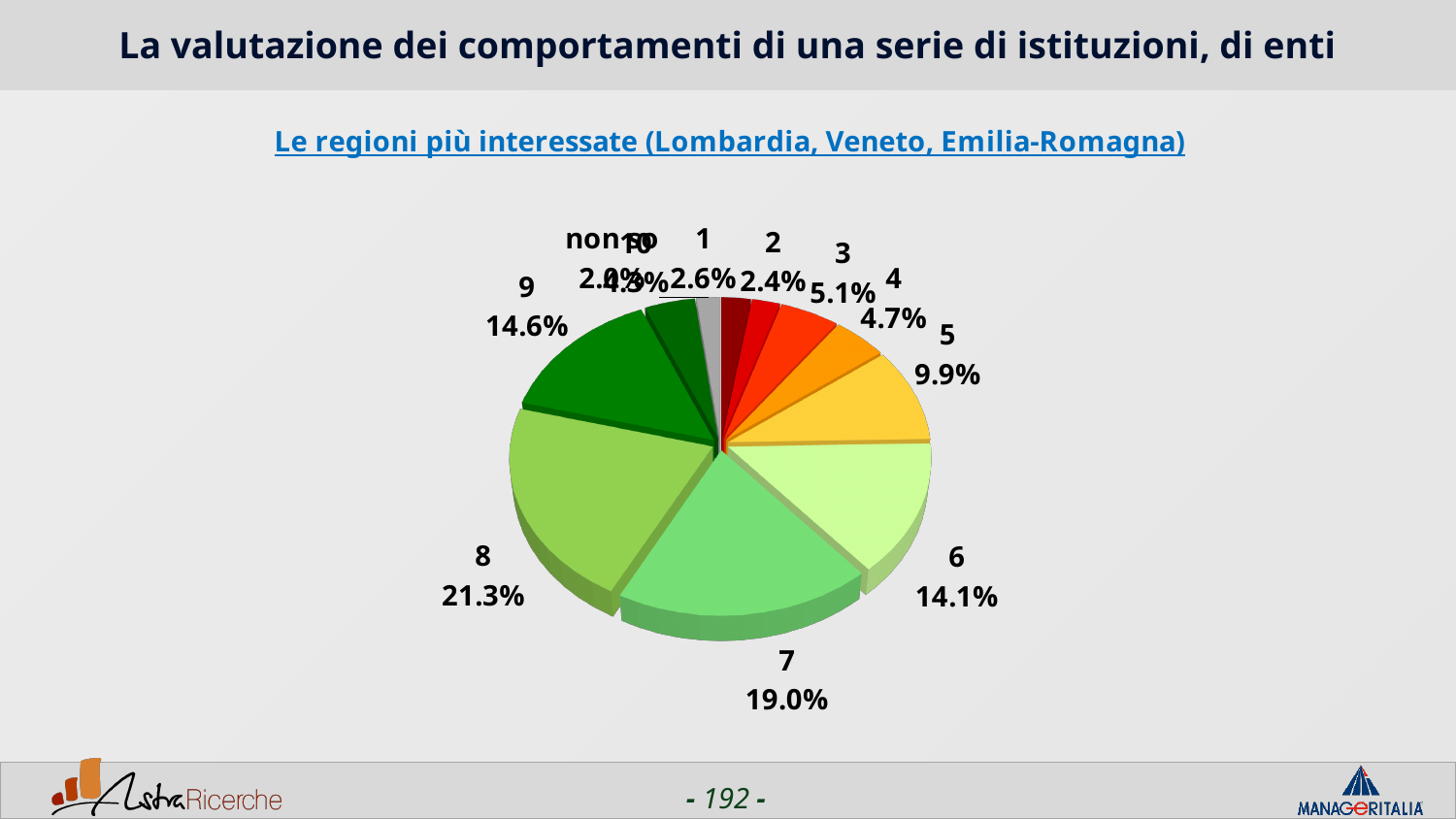
What percentage is shown for category 8? 21.3% What percentage is shown for category 9? 14.6% Which has the larger share, category 6 or category 9? 9 What is the difference in percentage points between category 8 and category 7? 2.3% What kind of chart is shown on the slide? pie chart What percentage is shown for category 3? 5.1% What percentage is shown for category 7? 19.0% Which regions are named in the subtitle above the chart? Lombardia, Veneto, Emilia-Romagna What percentage is shown for category 1? 2.6% What percentage is shown for category 5? 9.9% Which category has the largest slice of the pie? 8 What percentage is shown for category 6? 14.1%